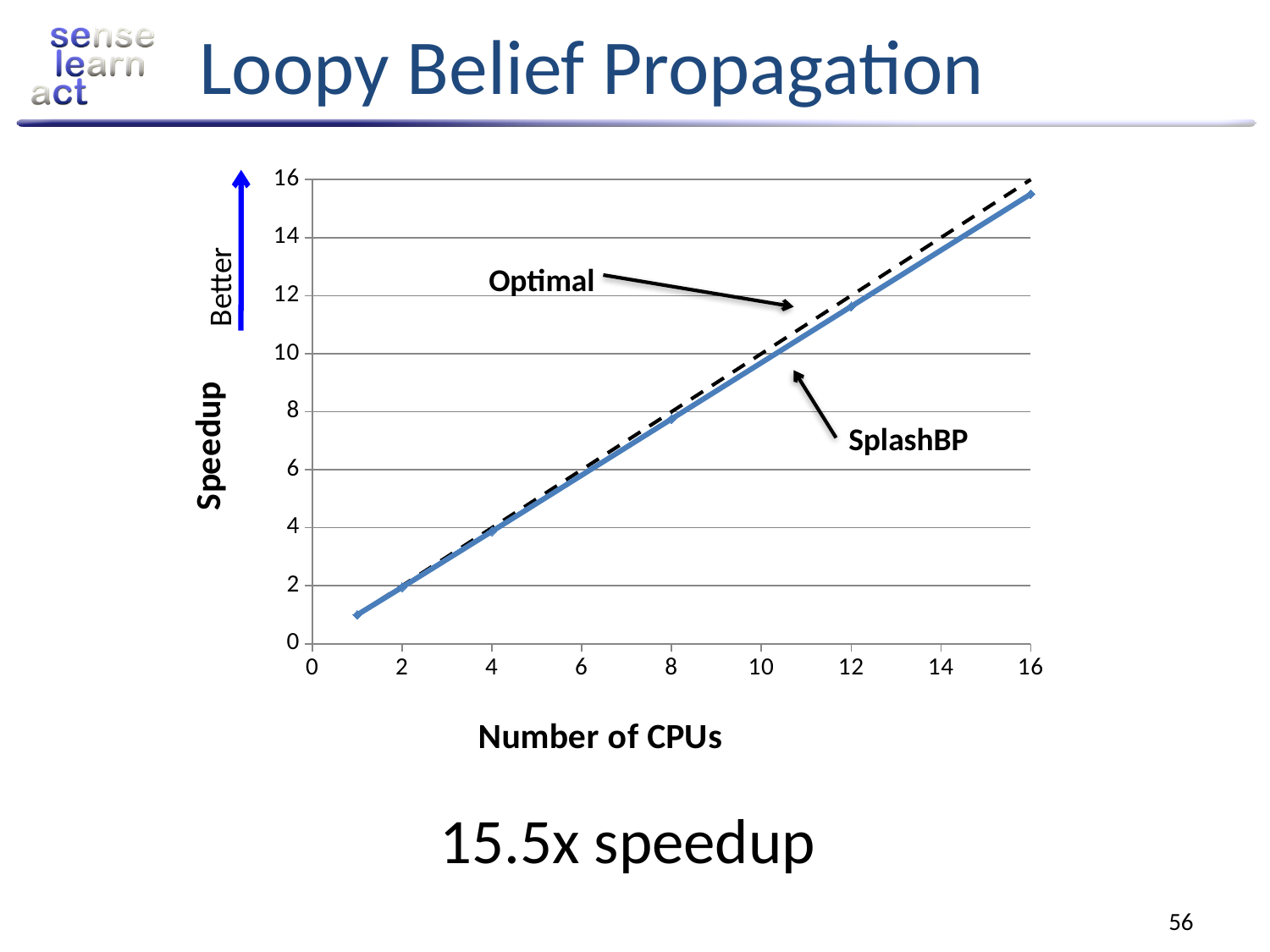
Is the SplashBP speedup at 8 CPUs greater or less than 10? less Is the SplashBP speedup at 12 CPUs greater or less than 10? greater At 16 CPUs, which line is higher, Optimal or SplashBP? Optimal Which series is drawn as a dashed line? Optimal What is the highest value shown on the x axis? 16 What is the title of the x axis? Number of CPUs How many lines are plotted on the chart? 2 Is the SplashBP speedup at 4 CPUs greater or less than 6? less What kind of chart is shown on the slide? line chart What speedup does the slide report for SplashBP at 16 CPUs? 15.5x Does the SplashBP speedup rise or fall as the number of CPUs increases? rises